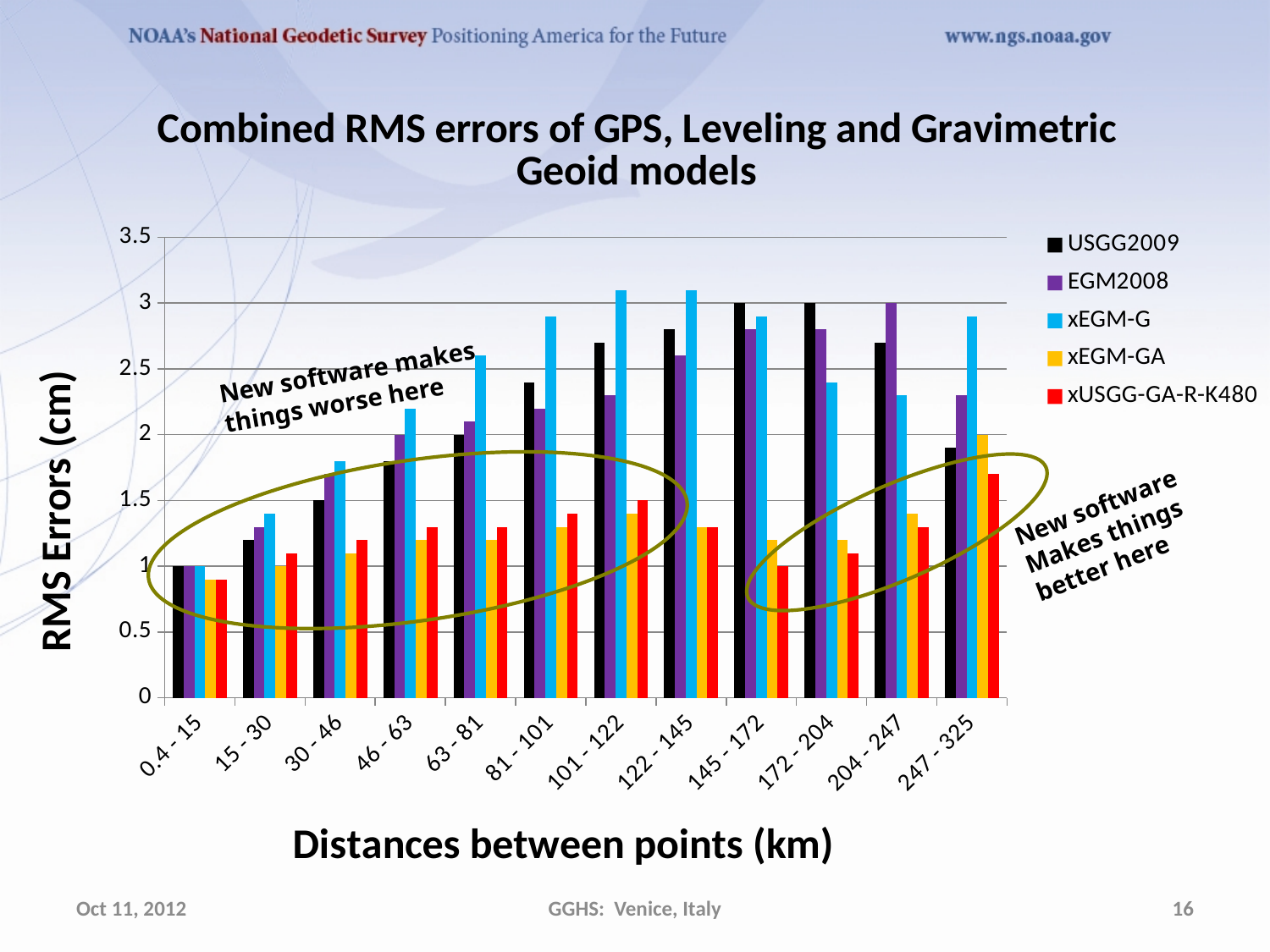
Is the value for xUSGG-GA-R-K480 in the 0.4 - 15 km category greater or less than 1? less What is the label of the y axis? RMS Errors (cm) Is the value for xEGM-G in the 101 - 122 km category greater or less than 3? greater In the 247 - 325 km category, which is larger: xEGM-G or EGM2008? xEGM-G In which distance category is the xUSGG-GA-R-K480 RMS error highest? 247 - 325 What is the RMS error for xEGM-GA in the 247 - 325 km category? 2 What is the RMS error for USGG2009 in the 145 - 172 km category? 3 What kind of chart is shown on the slide? bar chart Is the value for xEGM-G in the 247 - 325 km category greater or less than 2.5? greater What is the RMS error for USGG2009 in the 0.4 - 15 km category? 1 How many distance categories are shown on the x axis? 12 How many series does the legend list? 5